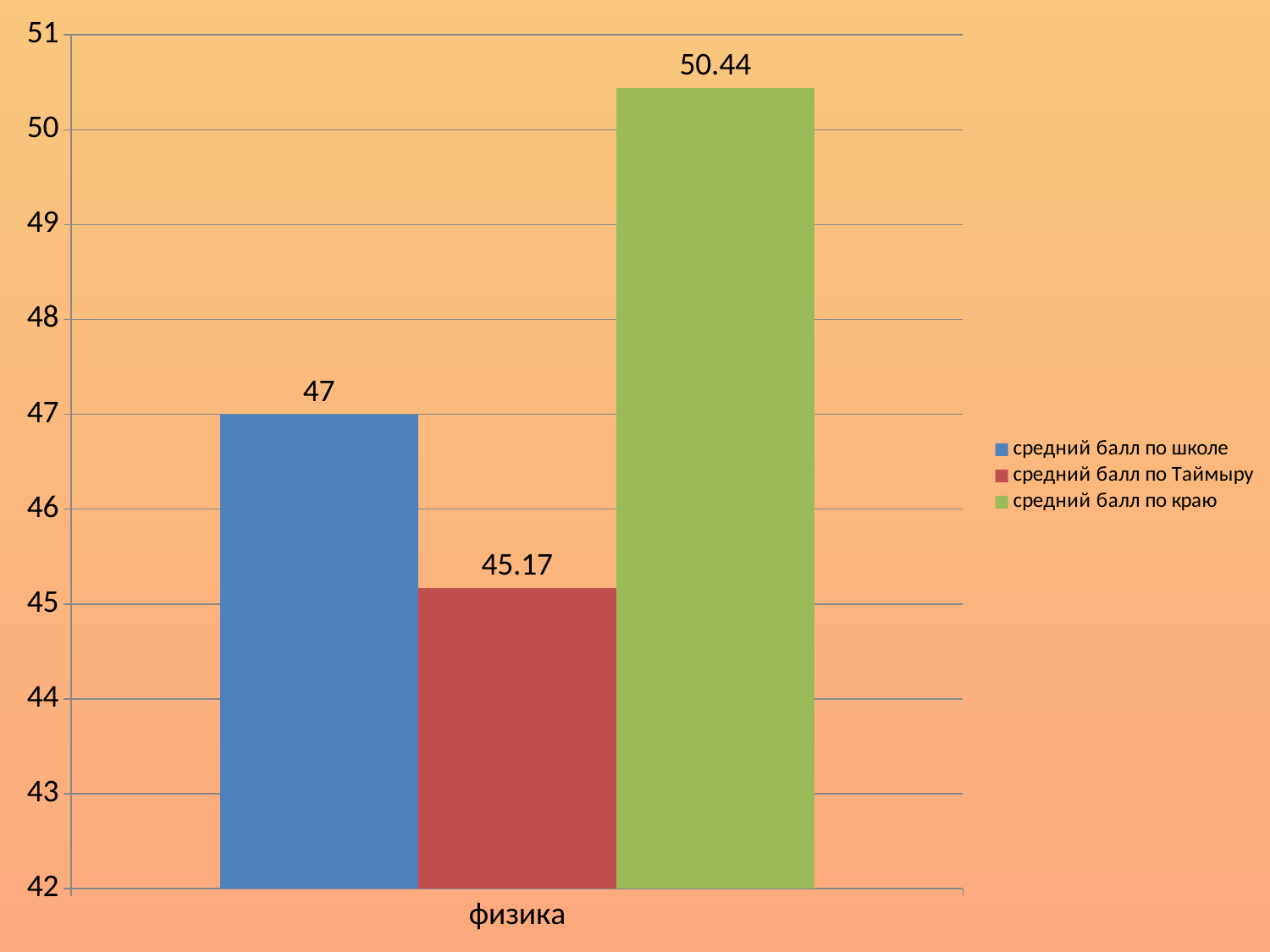
What is the value for "средний балл по краю" for физика? 50.44 What is the difference between "средний балл по школе" and "средний балл по Таймыру" for физика? 1.83 What is the difference between "средний балл по краю" and "средний балл по школе" for физика? 3.44 Which is larger for физика: "средний балл по школе" or "средний балл по Таймыру"? средний балл по школе Which series has the highest value for физика? средний балл по краю Is the value for "средний балл по краю" greater or less than 50? greater What is the value for "средний балл по Таймыру" for физика? 45.17 What kind of chart is shown on the slide? bar chart What colour is the bar for "средний балл по краю"? green Which series has the lowest value for физика? средний балл по Таймыру How many series does the legend list? 3 What is the value for "средний балл по школе" for физика? 47